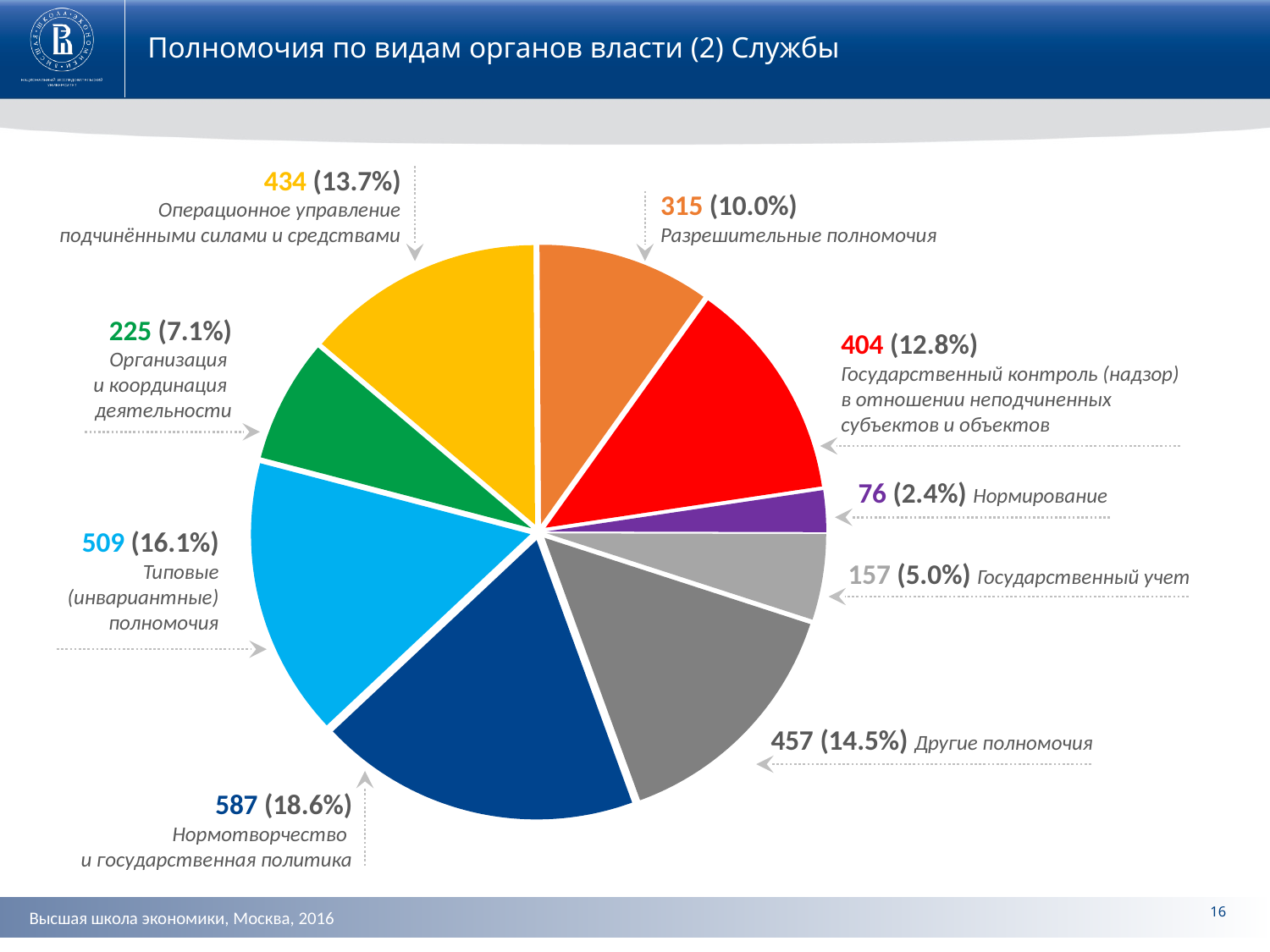
What is the value for «Государственный учет»? 157 (5.0%) Which category has the largest slice? Нормотворчество и государственная политика What is the value for «Нормирование»? 76 (2.4%) Which is larger: «Разрешительные полномочия» or «Государственный контроль (надзор) в отношении неподчиненных субъектов и объектов»? Государственный контроль (надзор) в отношении неподчиненных субъектов и объектов What is the difference in percentage points between «Типовые (инвариантные) полномочия» and «Организация и координация деятельности»? 9.0% What is the value for «Нормотворчество и государственная политика»? 587 (18.6%) What share of the pie does «Типовые (инвариантные) полномочия» take? 16.1% What is the difference between the values for «Другие полномочия» and «Операционное управление подчинёнными силами и средствами»? 23 What is the title of the slide containing the chart? Полномочия по видам органов власти (2) Службы Which category has the smallest slice? Нормирование What kind of chart is shown on the slide? pie chart How many slices does the pie chart have? 9